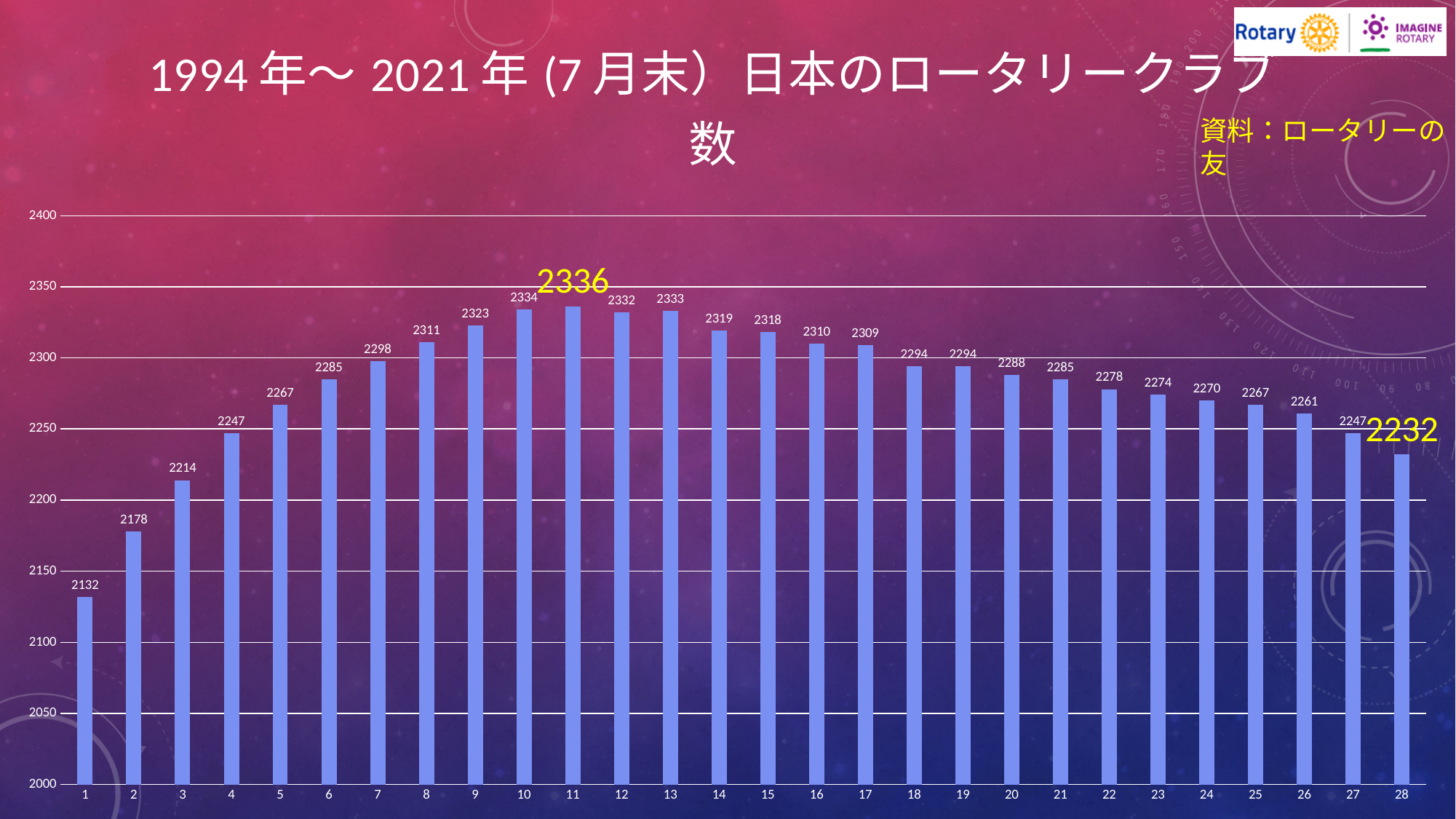
What is the difference between the values for category 11 and category 28? 104 Which category has the highest value? 11 Which is larger, the value for category 9 or the value for category 16? category 9 What is the value for category 20? 2288 What is the difference between the values for category 2 and category 1? 46 Which category has the lowest value? 1 What is the value for category 28? 2232 What is the value for category 1? 2132 What is the value for category 11? 2336 Is the value for category 4 greater or less than 2250? less How many categories are shown on the x axis? 28 What kind of chart is shown on the slide? bar chart